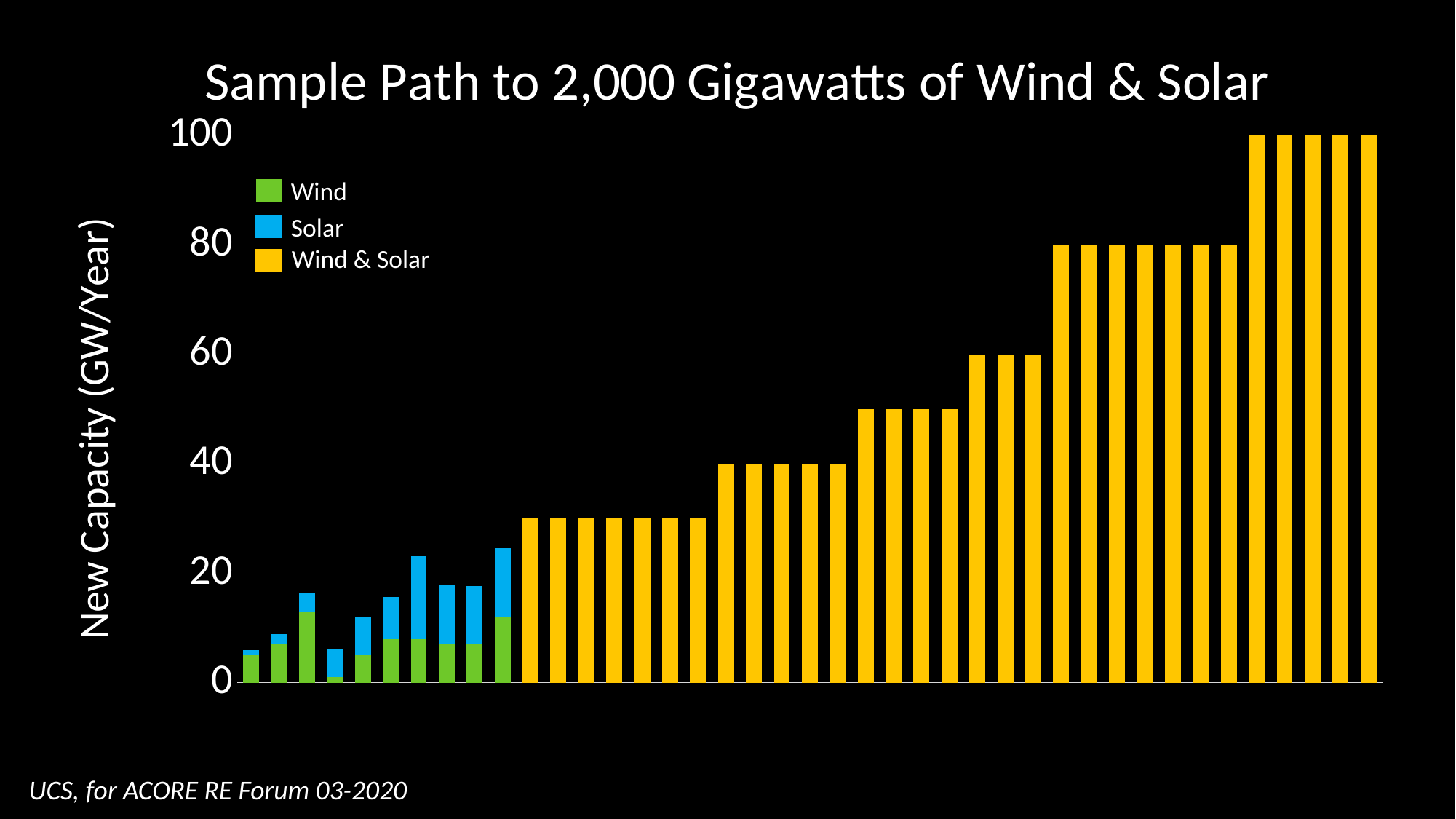
What value do the bars in the group immediately to the left of the tallest group reach? 80 How many bars reach the 60 level? 3 What is the title of the chart? Sample Path to 2,000 Gigawatts of Wind & Solar How many bars reach the 100 level? 5 Is the value of the leftmost bar greater or less than 20? less What is the label on the vertical axis? New Capacity (GW/Year) Do the bar heights generally rise or fall from left to right across the chart? rise What value do the tallest bars on the right of the chart reach? 100 Is the value of the rightmost bar greater or less than 80? greater How many series does the legend list? 3 Which is taller: the tallest yellow Wind & Solar bar or the tallest stacked Wind/Solar bar? the tallest yellow Wind & Solar bar What kind of chart is shown on the slide? bar chart